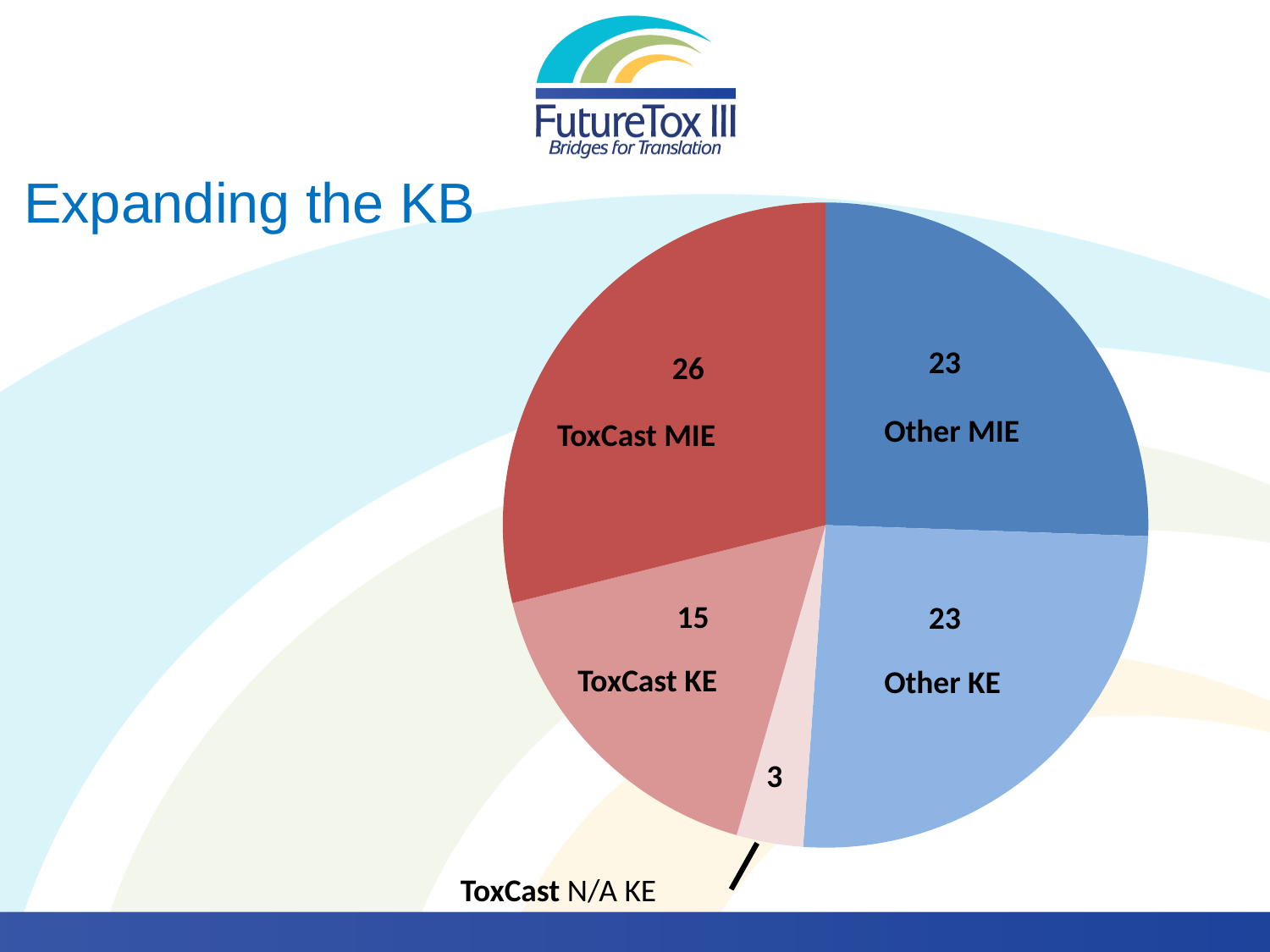
What is the value for ToxCast N/A KE? 3 Which is larger, ToxCast MIE or Other MIE? ToxCast MIE What is the difference between the ToxCast MIE value and the ToxCast KE value? 11 What is the value for ToxCast MIE? 26 What is the value for Other KE? 23 What is the title of the slide containing the pie chart? Expanding the KB What is the value for ToxCast KE? 15 How many slices does the pie chart have? 5 Which slice of the pie is the smallest? ToxCast N/A KE What kind of chart is shown on the slide? pie chart Which slice of the pie is the largest? ToxCast MIE What is the total of all the slices in the pie chart? 90